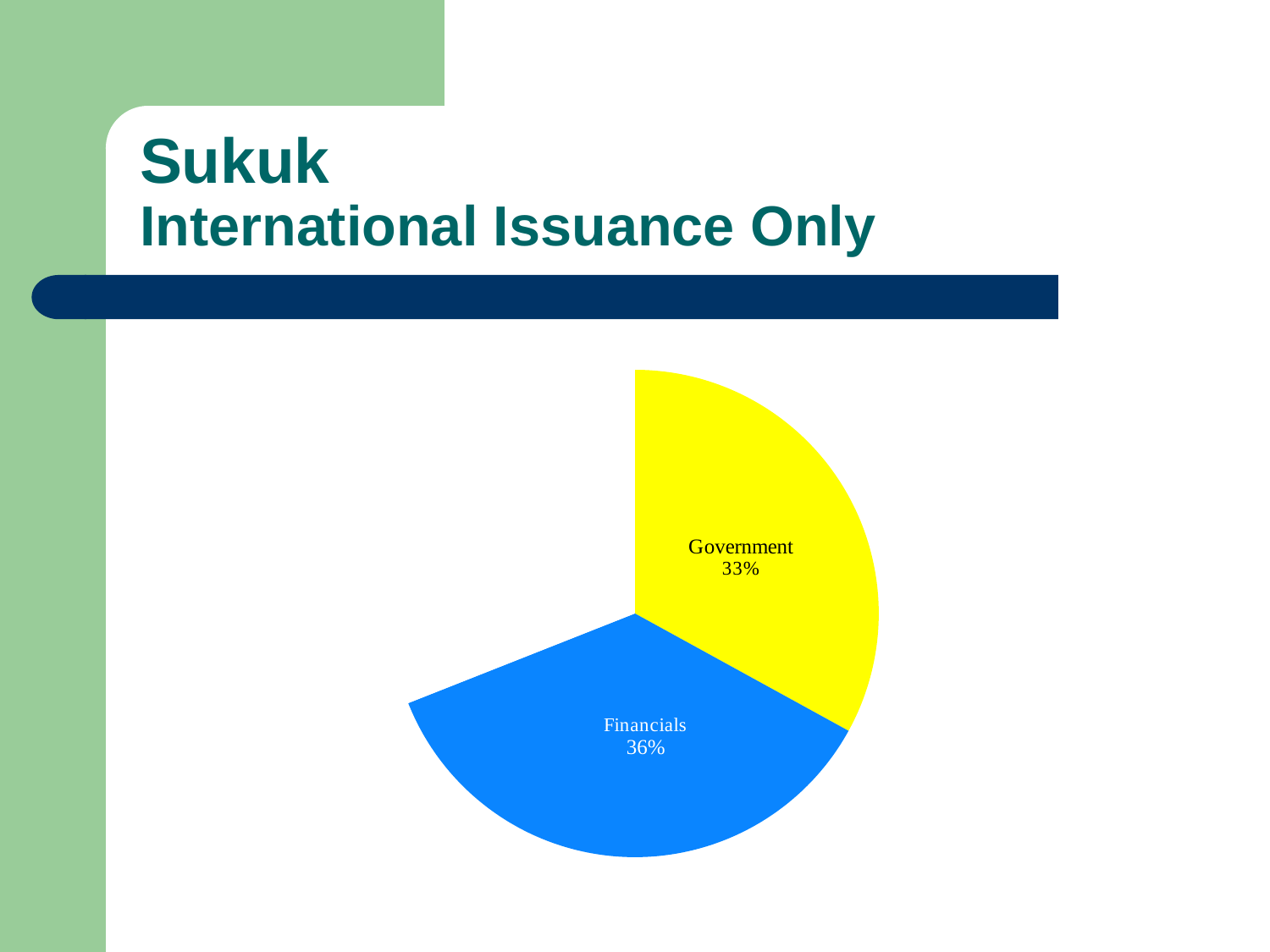
What kind of chart is shown on the slide? Pie chart What share of the pie does the Financials slice take? 36% What is the title of the slide containing the pie chart? Sukuk International Issuance Only By how many percentage points does the Financials slice exceed the Government slice? 3% What share of the pie does the Government slice take? 33% What percentage does the Government slice represent in the pie chart? 33% Which is larger in the pie chart, the Government slice or the Financials slice? Financials What colour is the Government slice in the pie chart? Yellow What percentage does the Financials slice represent in the pie chart? 36%